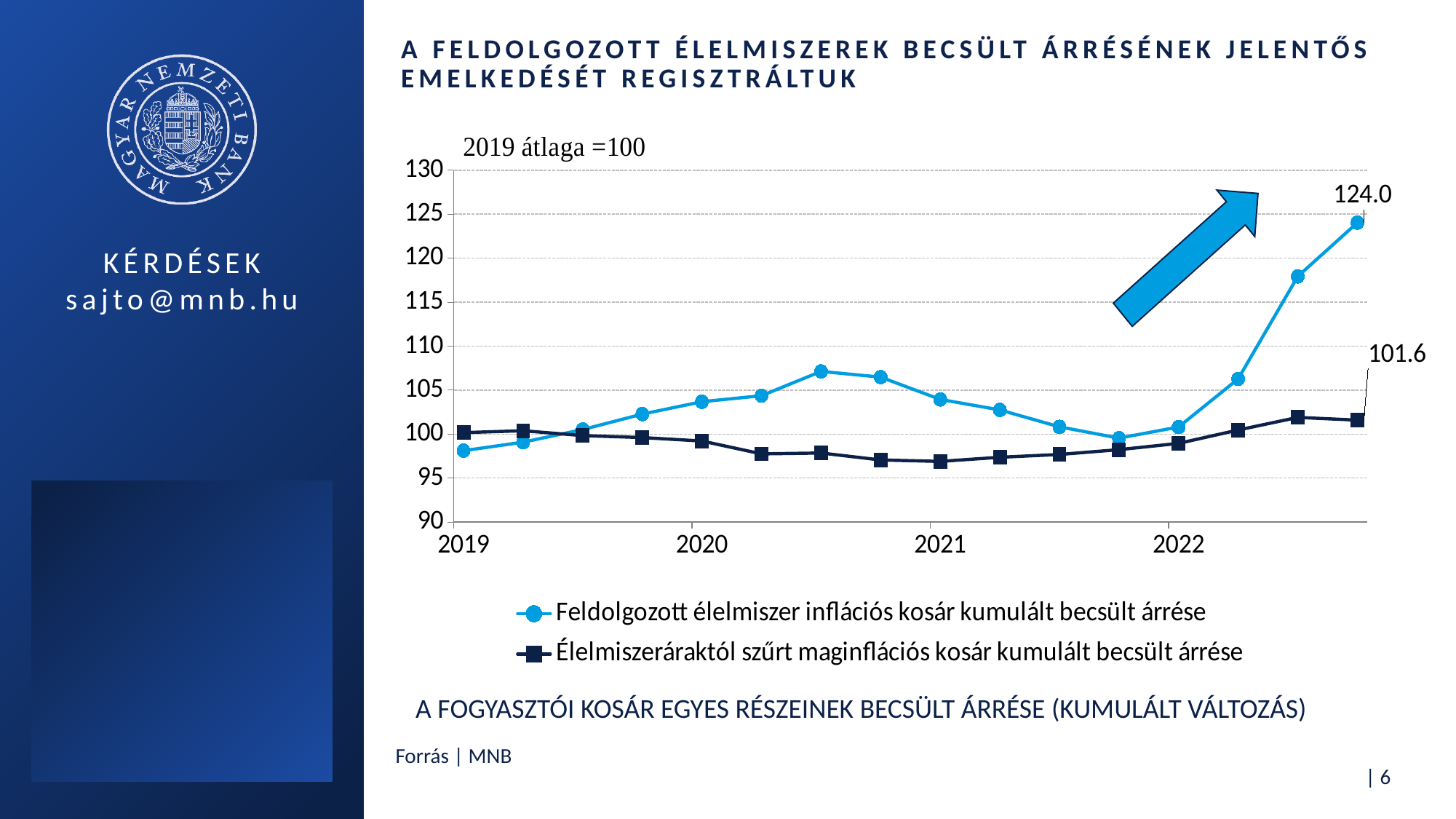
What base is stated above the chart for the index? 2019 átlaga =100 Is the value of the 'Élelmiszeráraktól szűrt maginflációs kosár' series at 2021 greater or less than 100? less Which series has the higher value at the end of the chart? Feldolgozott élelmiszer inflációs kosár kumulált becsült árrése Does the 'Feldolgozott élelmiszer' series rise or fall from 2022 to the end of the chart? rise How many series does the legend list? 2 What is the final labelled value of the 'Élelmiszeráraktól szűrt maginflációs kosár kumulált becsült árrése' series? 101.6 What type of chart is shown on the slide? line chart Is the peak of the 'Feldolgozott élelmiszer' series in mid-2020 greater or less than 105? greater How many data points does each series have on the chart? 16 What is the difference between the two labelled end values, 124.0 and 101.6? 22.4 What is the final labelled value of the 'Feldolgozott élelmiszer inflációs kosár kumulált becsült árrése' series? 124.0 Is the value of the 'Feldolgozott élelmiszer' series at 2021 greater or less than 100? greater